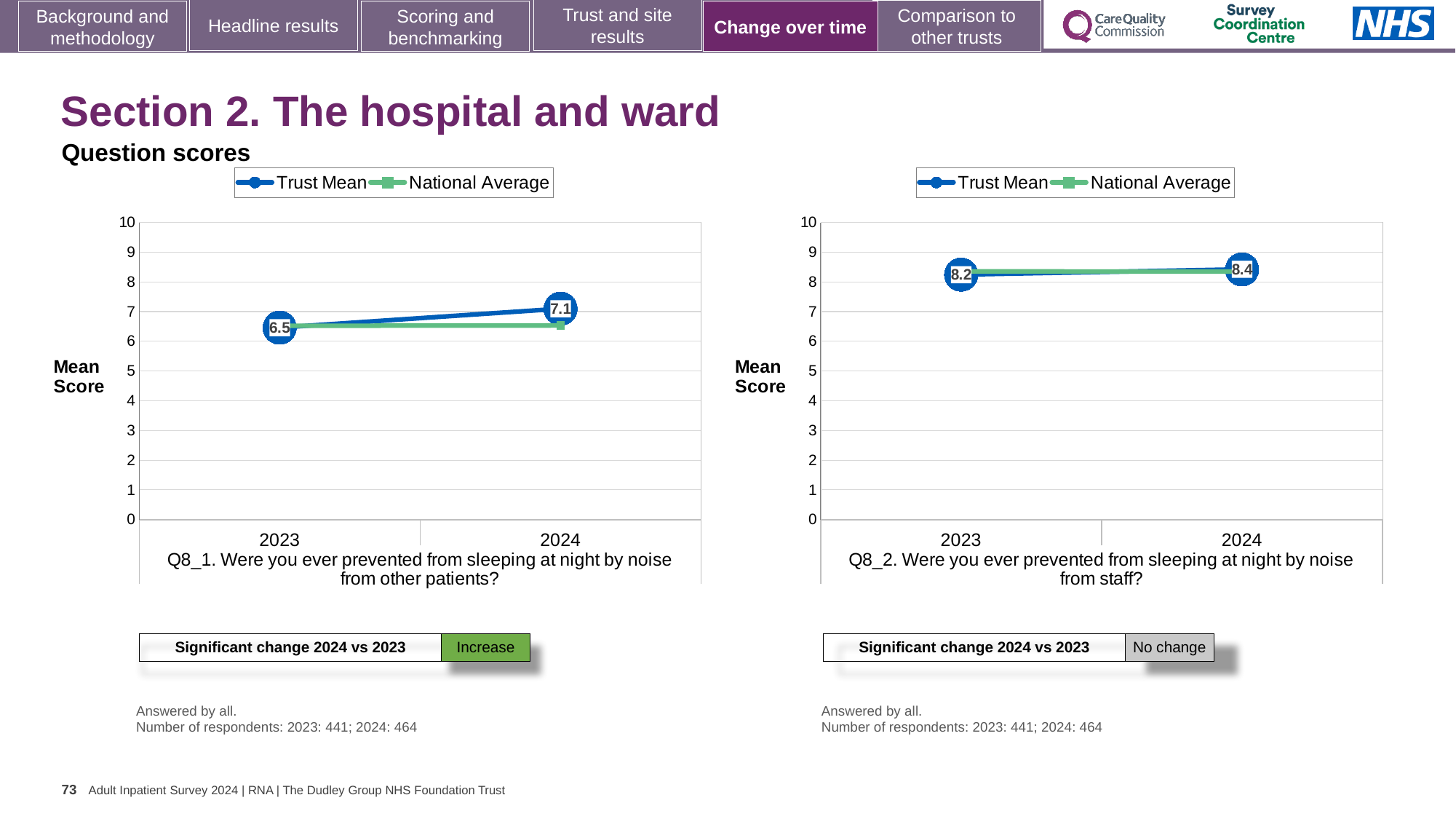
In the Q8_2 chart (right), what is the Trust Mean score for 2023? 8.2 What kind of chart is used for the Q8_2 question scores on the right? line chart In the Q8_1 chart (left), what is the Trust Mean score for 2023? 6.5 How many years are shown on the x axis of the Q8_2 chart (right)? 2 How many series does the legend of the Q8_1 chart (left) list? 2 In the Q8_1 chart (left), by how much did the Trust Mean change from 2023 to 2024? 0.6 In the Q8_2 chart (right), what is the difference between the Trust Mean for 2024 and 2023? 0.2 In the Q8_1 chart (left), is the National Average for 2024 greater or less than 7? less What significant change result is shown below the Q8_1 chart (left) for 2024 vs 2023? Increase In the Q8_2 chart (right), what is the Trust Mean score for 2024? 8.4 In the Q8_1 chart (left), what is the Trust Mean score for 2024? 7.1 In the Q8_1 chart (left), does the Trust Mean rise or fall from 2023 to 2024? rise